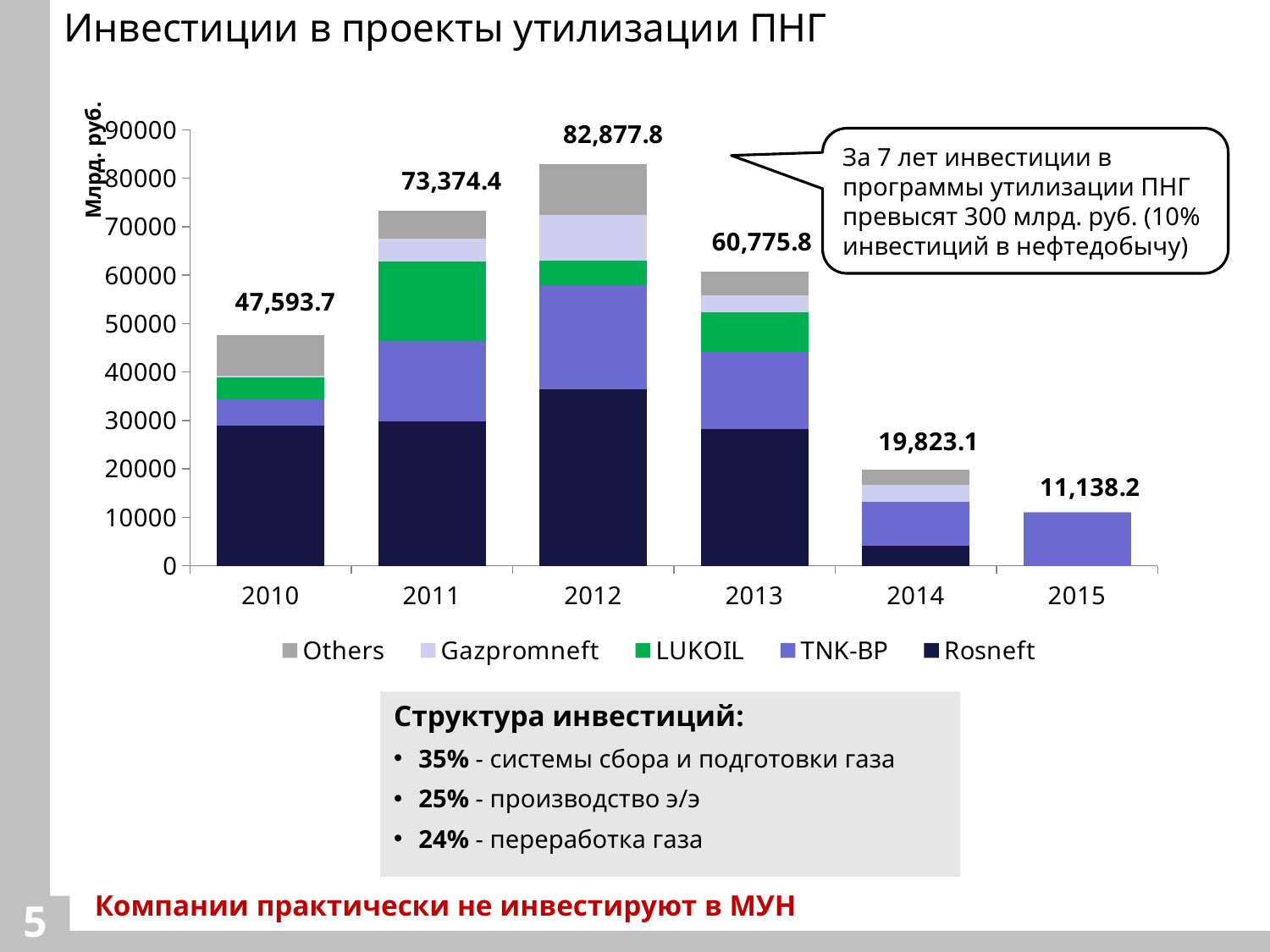
What is the total investment value shown for 2010? 47,593.7 What is the total investment value shown for 2012? 82,877.8 What is the difference between the total for 2014 and the total for 2015? 8,684.9 What is the difference between the total for 2012 and the total for 2011? 9,503.4 How many years are shown on the x axis? 6 Which year has the lowest total investment? 2015 What is the total investment value shown for 2015? 11,138.2 Is the Rosneft segment for 2012 greater or less than 30000? greater Which year has a larger total investment, 2011 or 2013? 2011 How many series does the legend list? 5 What kind of chart is shown on the slide? Stacked bar chart Which year has the highest total investment? 2012